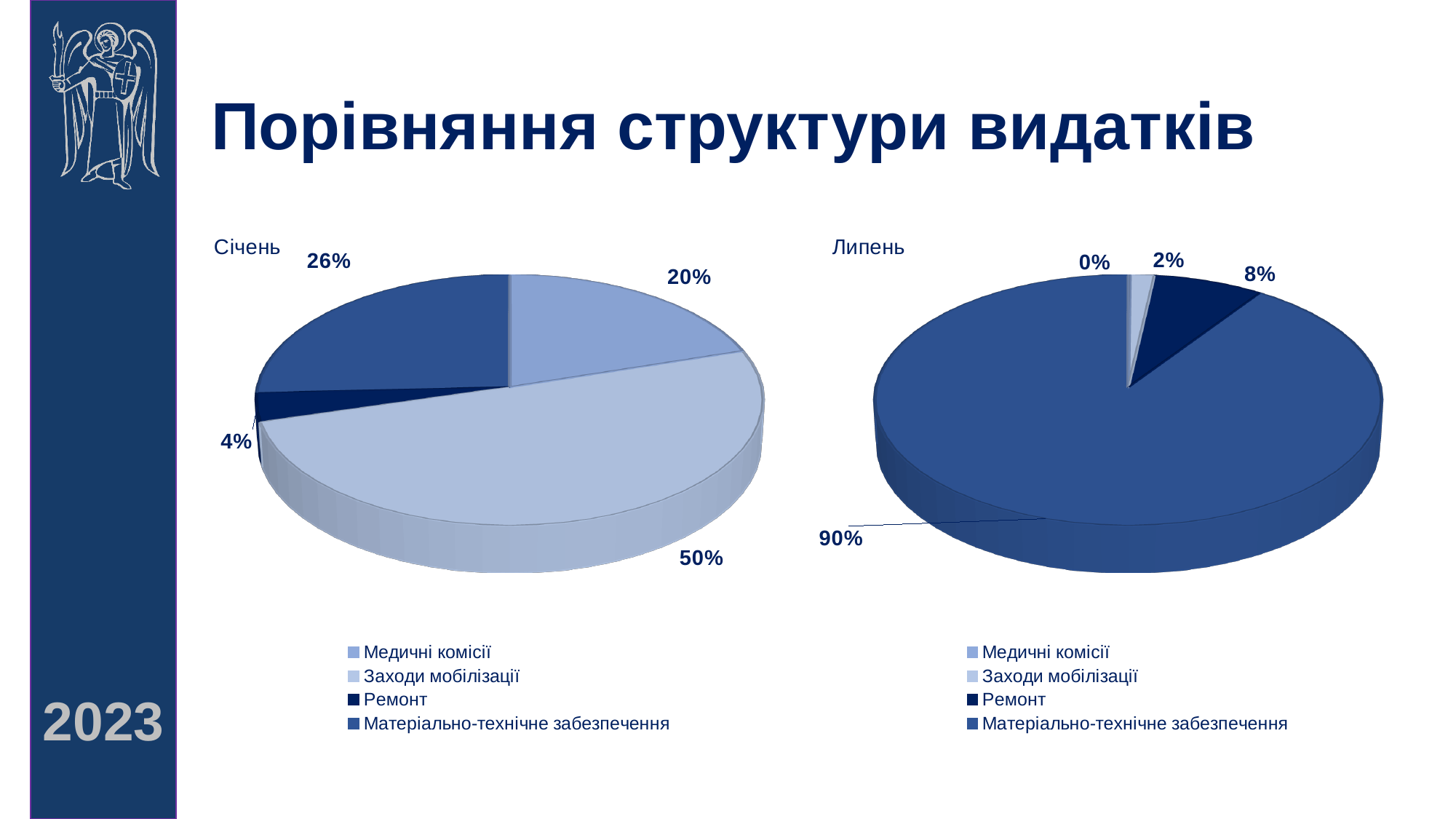
In the Січень pie chart, which category has the largest share? Заходи мобілізації In the Липень pie chart, what share is Матеріально-технічне забезпечення? 90% In the Січень pie chart, what share is Заходи мобілізації? 50% In the Липень pie chart, which category has the smallest share? Медичні комісії In the Липень pie chart, what share is Ремонт? 8% In the Січень pie chart, what share is Ремонт? 4% In the Січень pie chart, what share is Матеріально-технічне забезпечення? 26% How many categories does the legend of the Січень chart list? 4 In the Січень pie chart, what is the difference between the shares of Заходи мобілізації and Медичні комісії? 30% What type of chart is used for Липень? Pie chart In the Липень pie chart, what share is Медичні комісії? 0% In the Липень pie chart, which is larger: Ремонт or Заходи мобілізації? Ремонт